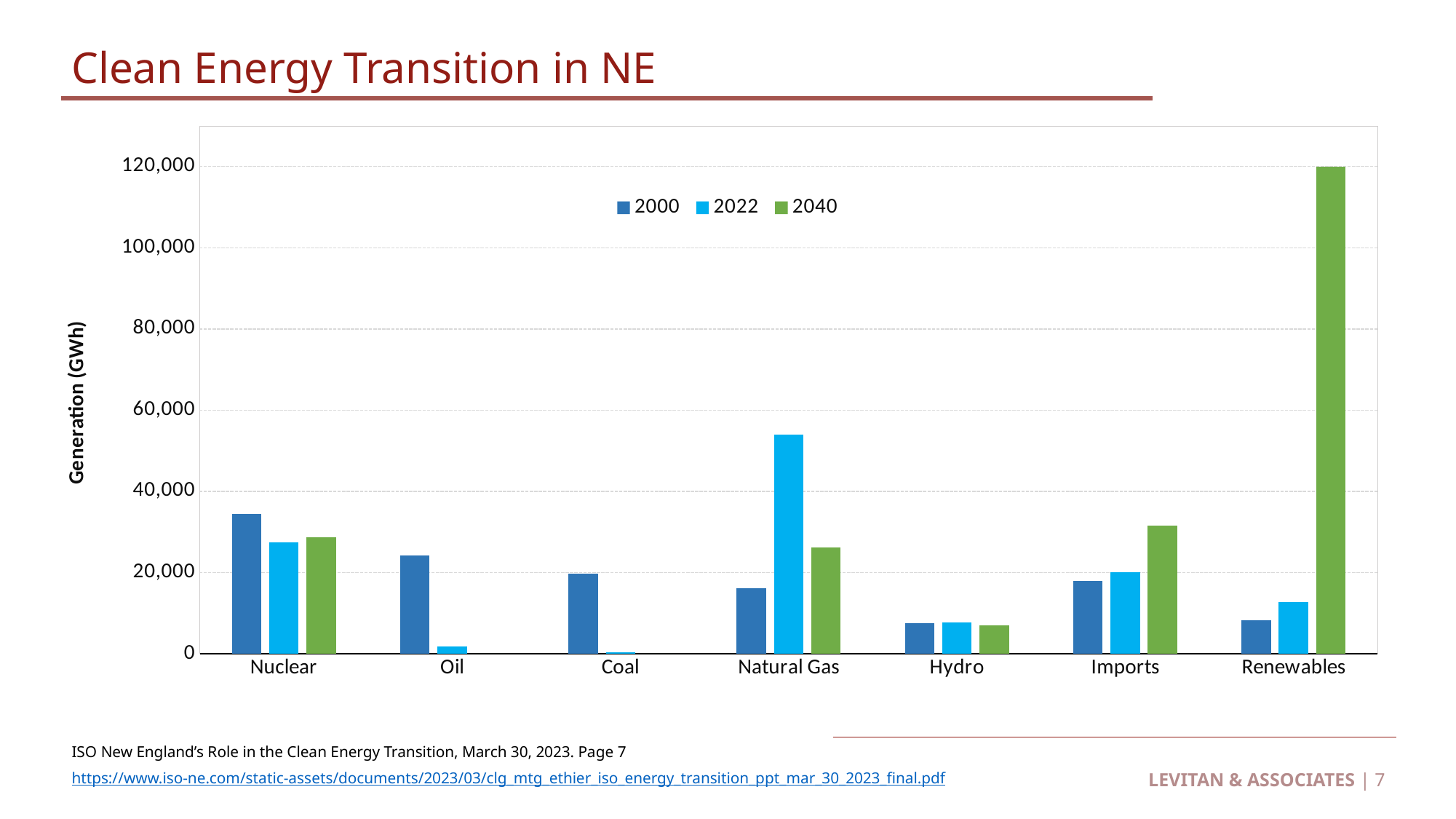
Is the value for Natural Gas in 2022 greater or less than 40,000? greater What kind of chart is shown on the slide? Bar chart Is the value for Renewables in 2040 greater or less than 100,000? greater Which is larger: Oil in 2000 or Coal in 2000? Oil in 2000 Which is larger: Natural Gas in 2022 or Nuclear in 2000? Natural Gas in 2022 Is the value for Nuclear in 2000 greater or less than 40,000? less How many series does the legend list? 3 Which category and year has the tallest bar in the chart? Renewables, 2040 How many categories are shown on the x axis? 7 Which category has the highest bar for 2000? Nuclear Do the Renewables values rise or fall from 2000 to 2040? rise What are the three legend entries? 2000, 2022, 2040